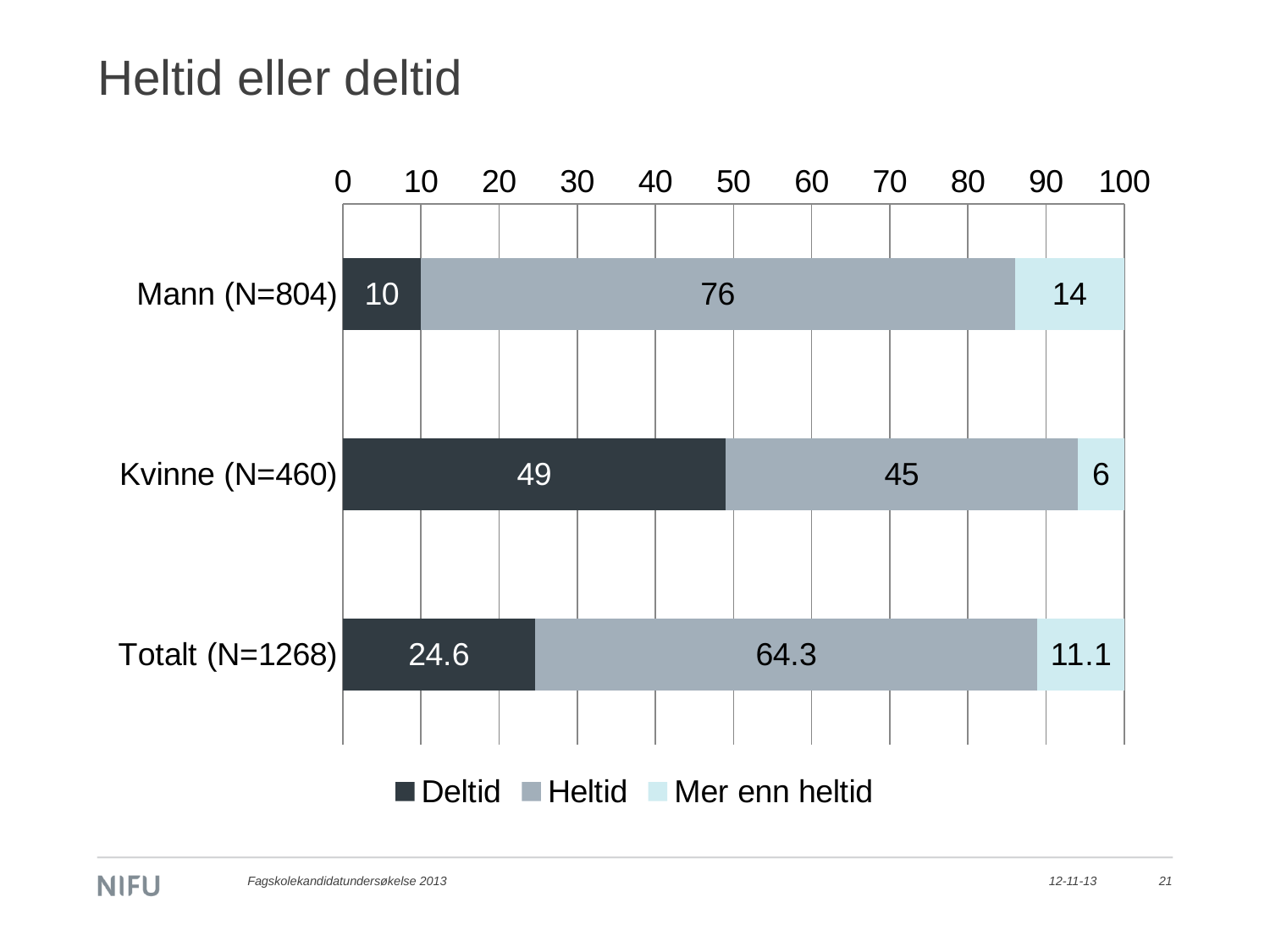
What is the Heltid value for Kvinne (N=460)? 45 Which is larger: the Deltid value for Kvinne (N=460) or the Heltid value for Kvinne (N=460)? Deltid What is the Deltid value for Mann (N=804)? 10 Which category has the lowest Mer enn heltid value? Kvinne (N=460) What is the difference between the Heltid values for Mann (N=804) and Kvinne (N=460)? 31 What is the Mer enn heltid value for Totalt (N=1268)? 11.1 Which category has the highest Deltid value? Kvinne (N=460) What is the title of the slide? Heltid eller deltid What kind of chart is shown? Stacked bar chart How many series does the legend list? 3 How many categories are shown on the y axis? 3 What is the total of the stacked bar for Totalt (N=1268)? 100